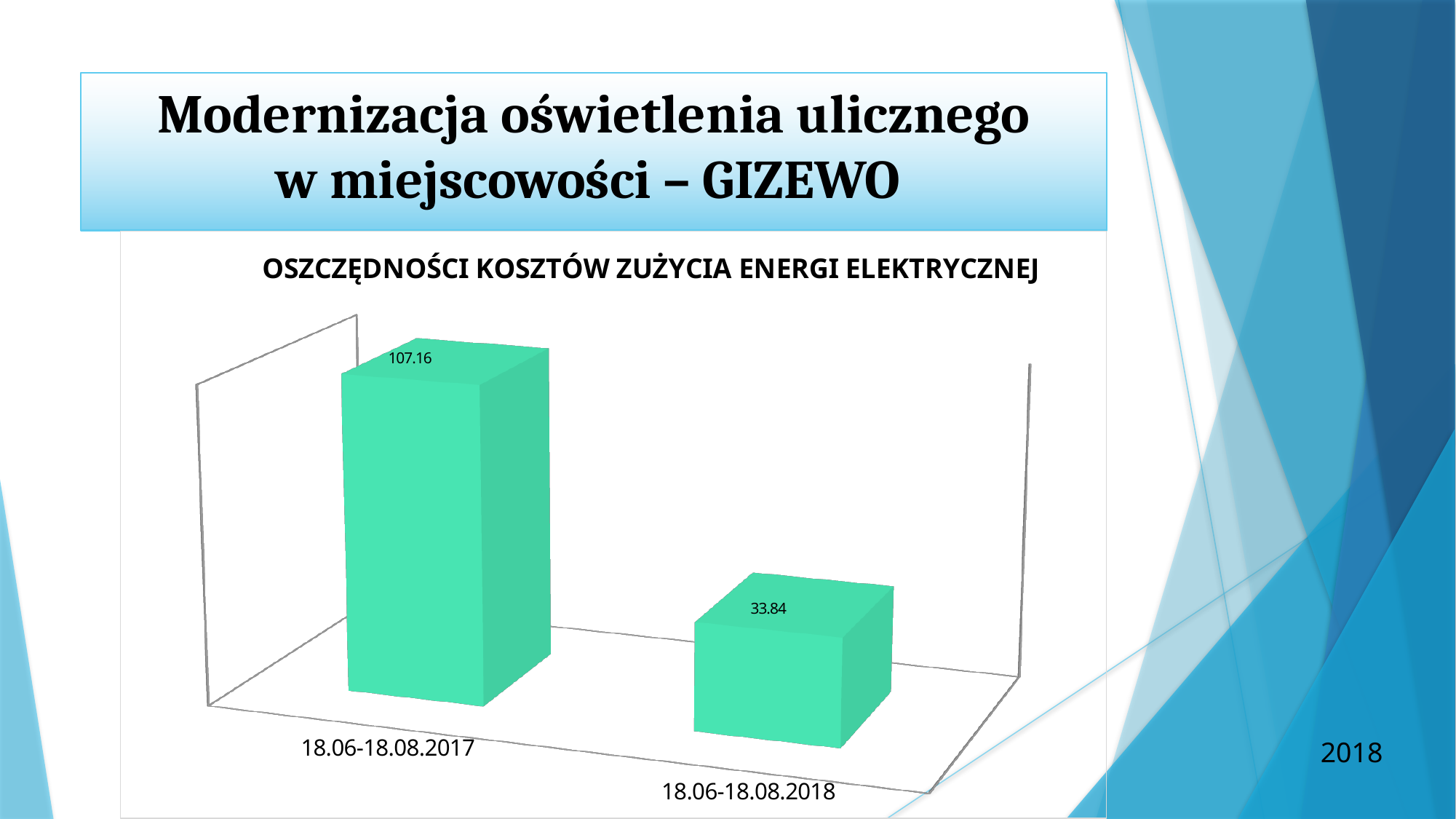
What is the value for 18.06-18.08.2018? 33.84 What is the value for 18.06-18.08.2017? 107.16 Do the values rise or fall from 18.06-18.08.2017 to 18.06-18.08.2018? fall What colour are the bars in the chart? green Which category has the lowest value? 18.06-18.08.2018 What is the title of the chart? OSZCZĘDNOŚCI KOSZTÓW ZUŻYCIA ENERGI ELEKTRYCZNEJ How many categories are shown in the chart? 2 Which category has the highest value? 18.06-18.08.2017 What is the difference between the values for 18.06-18.08.2017 and 18.06-18.08.2018? 73.32 What kind of chart is shown on the slide? bar chart Which is larger, the value for 18.06-18.08.2017 or for 18.06-18.08.2018? 18.06-18.08.2017